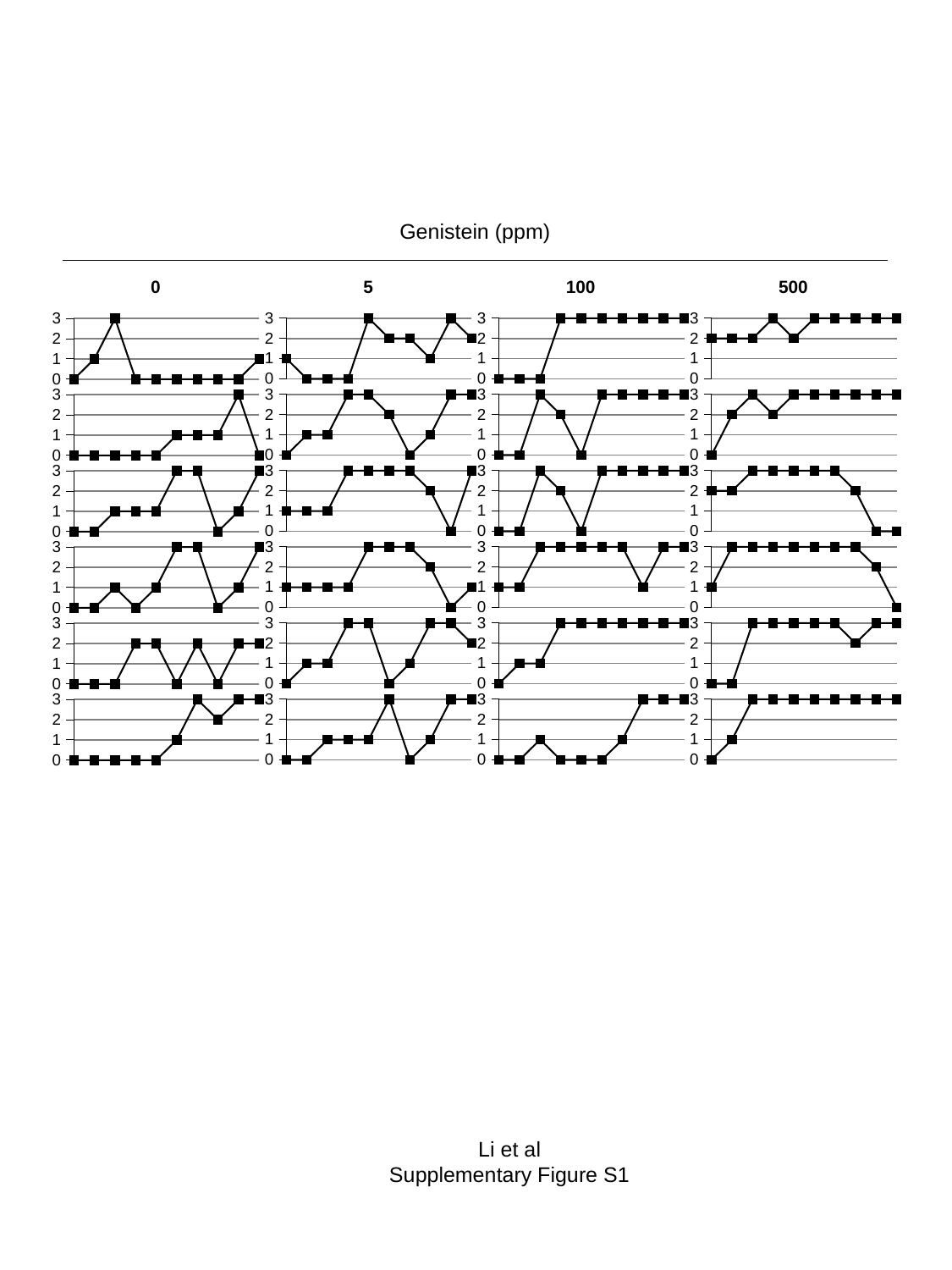
What are the four column headings above the grid of charts? 0, 5, 100, 500 In the top chart of the 500 ppm column, what is the value of the first data point? 2 What is the highest value shown on the y axis of each chart? 3 In the top chart of the 0 ppm column, what is the value of the third data point? 3 How many small charts are arranged in the grid on this slide? 24 In the bottom chart of the 0 ppm column, what is the value of the last data point? 3 In the top chart of the 0 ppm column, how many data points are plotted? 10 In the bottom chart of the 500 ppm column, what is the value of the second data point? 1 In the top chart of the 0 ppm column, which is larger: the second data point or the third data point? the third data point In the top chart of the 0 ppm column, what is the difference between the third data point and the first data point? 3 What kind of chart is used in each panel of the grid on this slide? line chart In the top chart of the 100 ppm column, do the values rise or fall from left to right? rise